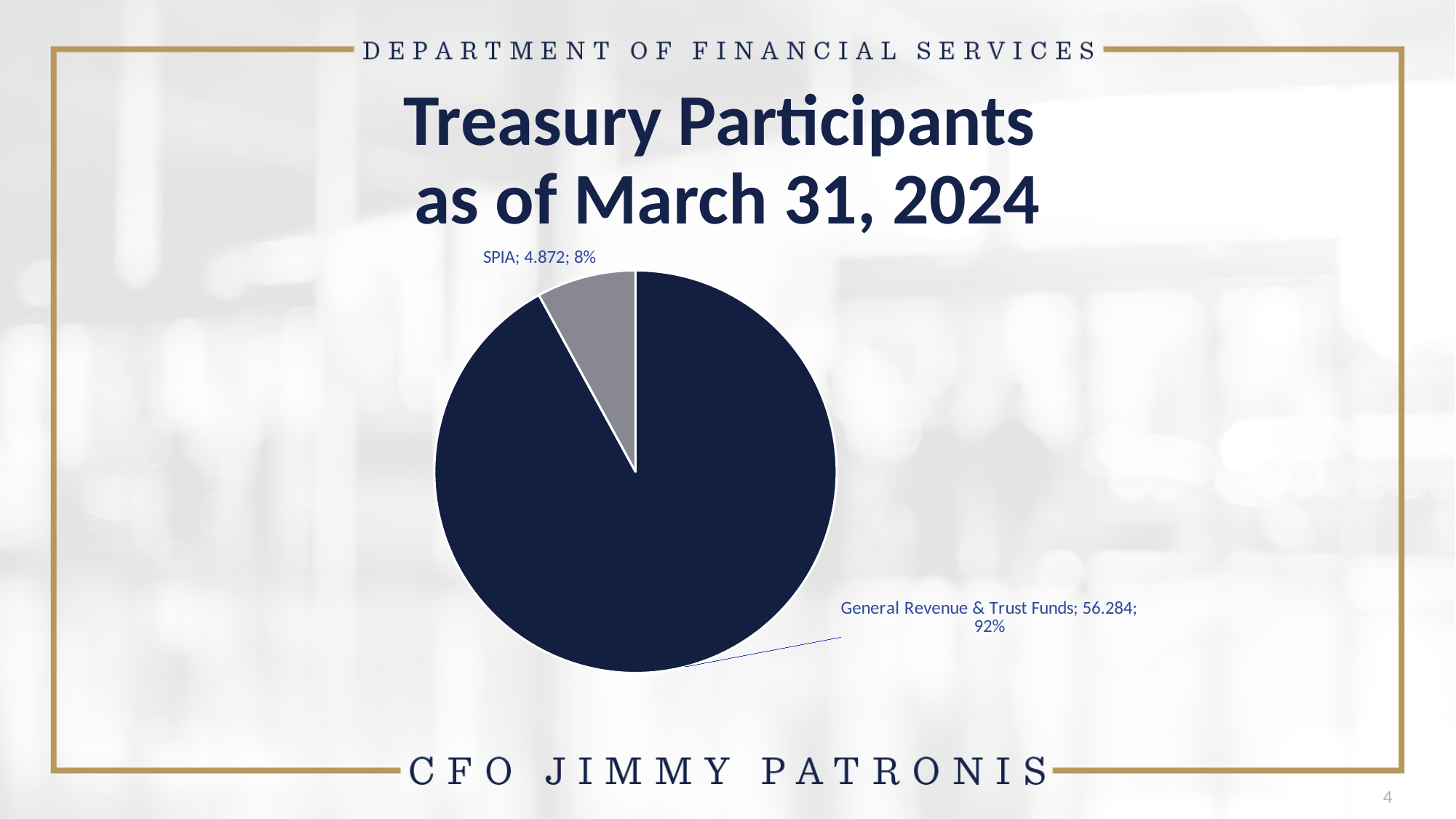
What is the difference between the values for General Revenue & Trust Funds and SPIA? 51.412 What is the value shown for General Revenue & Trust Funds? 56.284 What kind of chart is shown on the slide? Pie chart Which slice of the pie is the smallest? SPIA Which slice of the pie is the largest? General Revenue & Trust Funds Which is larger, the value for SPIA or the value for General Revenue & Trust Funds? General Revenue & Trust Funds How many slices does the pie chart have? 2 What colour is the SPIA slice of the pie? Grey What share of the pie does SPIA represent? 8% What is the title of the chart on the slide? Treasury Participants as of March 31, 2024 What is the value shown for SPIA? 4.872 What share of the pie does General Revenue & Trust Funds represent? 92%